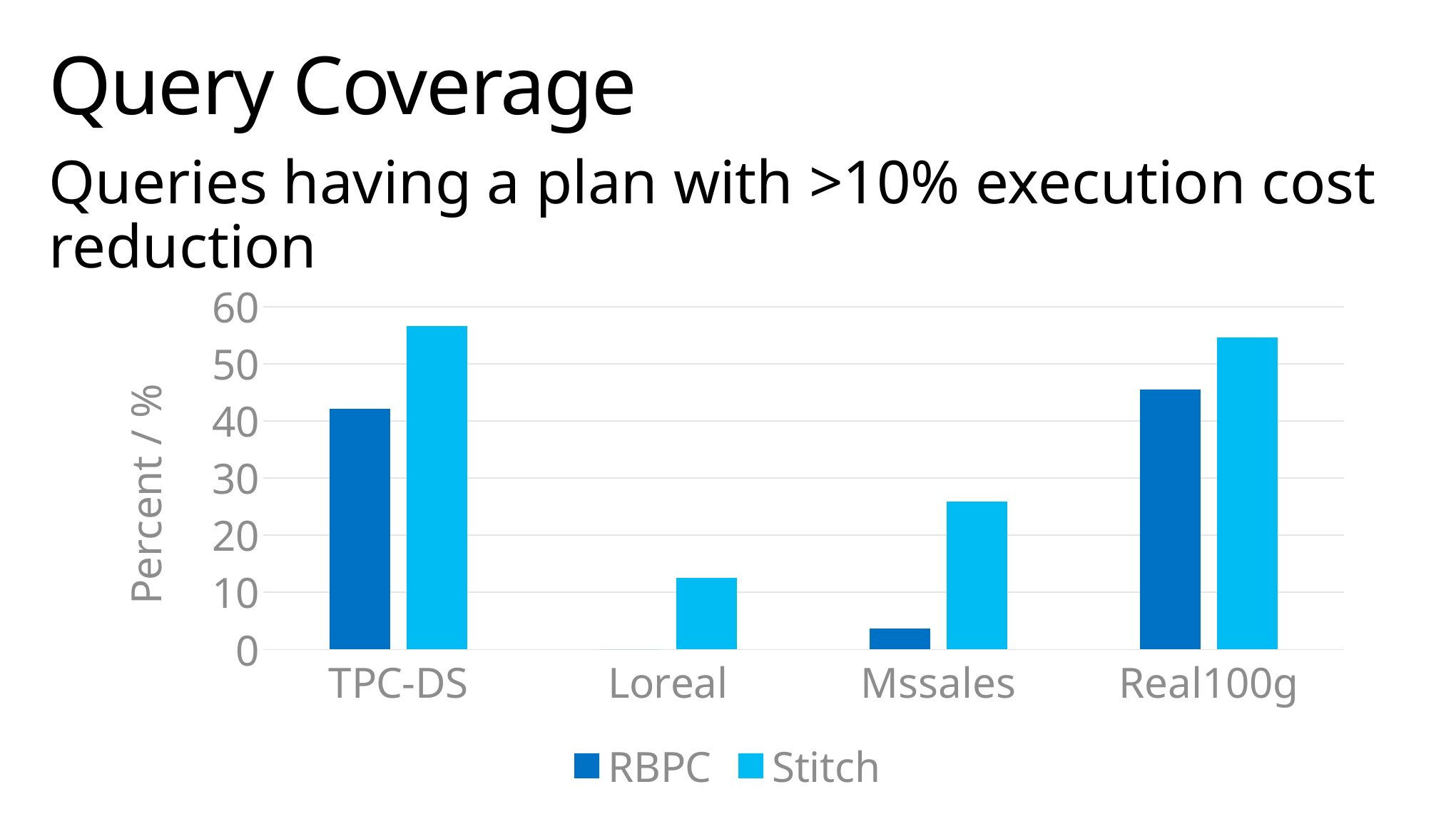
What kind of chart is shown on the slide? bar chart Which category has the highest RBPC value? Real100g Is the RBPC value for Mssales greater or less than 10? less Is the Stitch value for Mssales greater or less than 30? less What is the label on the y axis? Percent / % For TPC-DS, which series has the larger value, RBPC or Stitch? Stitch Is the Stitch value for TPC-DS greater or less than 50? greater How many categories are shown on the x axis? 4 For Mssales, which series has the larger value, RBPC or Stitch? Stitch Which category has the lowest Stitch value? Loreal How many series does the legend list? 2